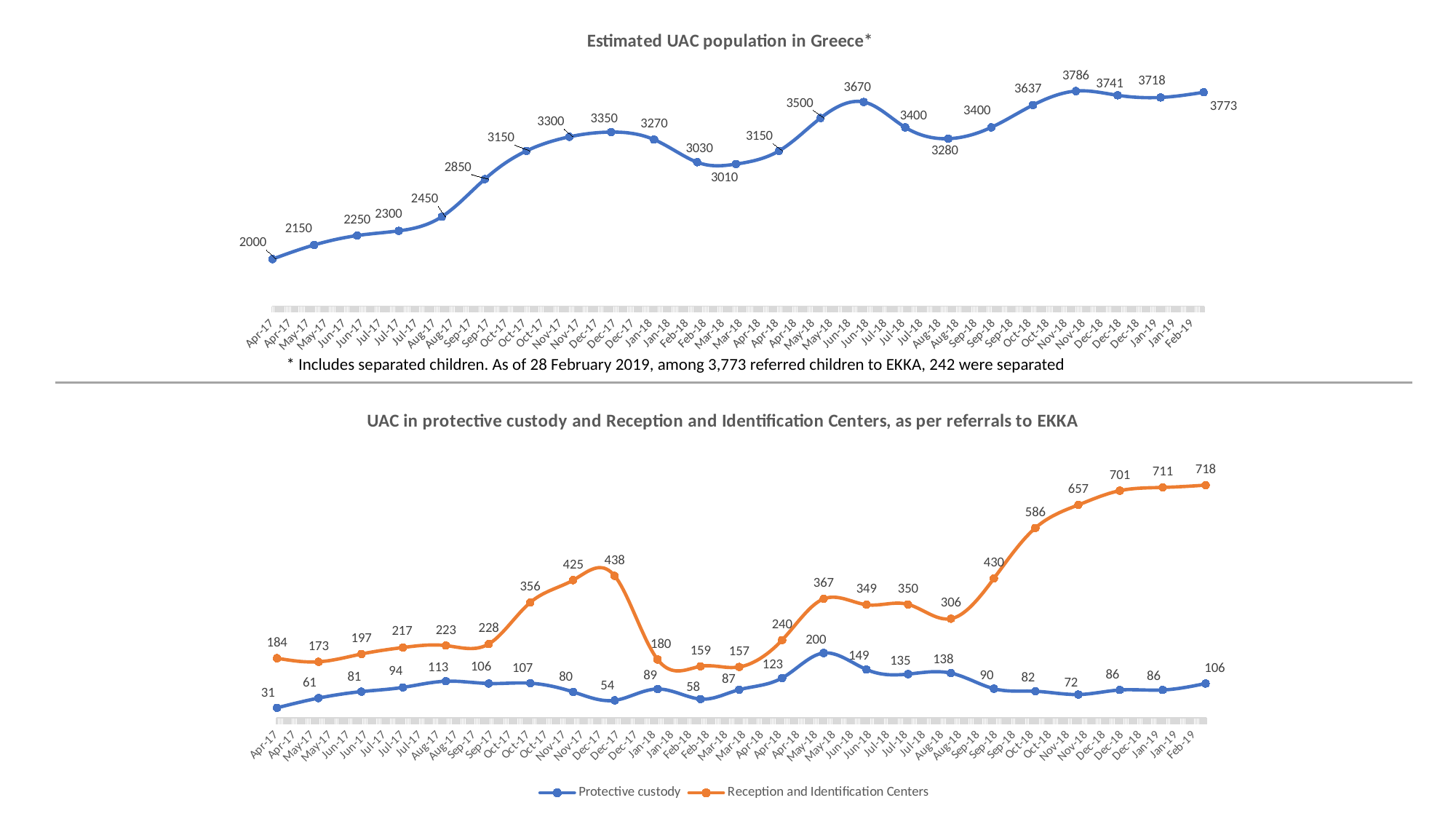
In the bottom chart, what is the lowest value for the Protective custody series? 31 In the 'Estimated UAC population in Greece*' chart, what is the value for Feb-19? 3773 What kind of chart is the 'Estimated UAC population in Greece*' chart? line chart How many series does the legend of the bottom chart ('UAC in protective custody and Reception and Identification Centers, as per referrals to EKKA') list? 2 In the bottom chart, which series has the higher value at Feb-19, Protective custody or Reception and Identification Centers? Reception and Identification Centers In the 'Estimated UAC population in Greece*' chart, what is the difference between the highest value (3786) and the lowest value (2000)? 1786 In the 'Estimated UAC population in Greece*' chart, what is the highest value plotted? 3786 In the bottom chart, what is the highest value for the Protective custody series? 200 In the 'Estimated UAC population in Greece*' chart, does the value overall rise or fall from Apr-17 to Feb-19? rise In the bottom chart, what is the difference between the Reception and Identification Centers value (718) and the Protective custody value (106) at Feb-19? 612 In the 'Estimated UAC population in Greece*' chart, what is the lowest value plotted? 2000 In the bottom chart, what is the highest value for the Reception and Identification Centers series? 718